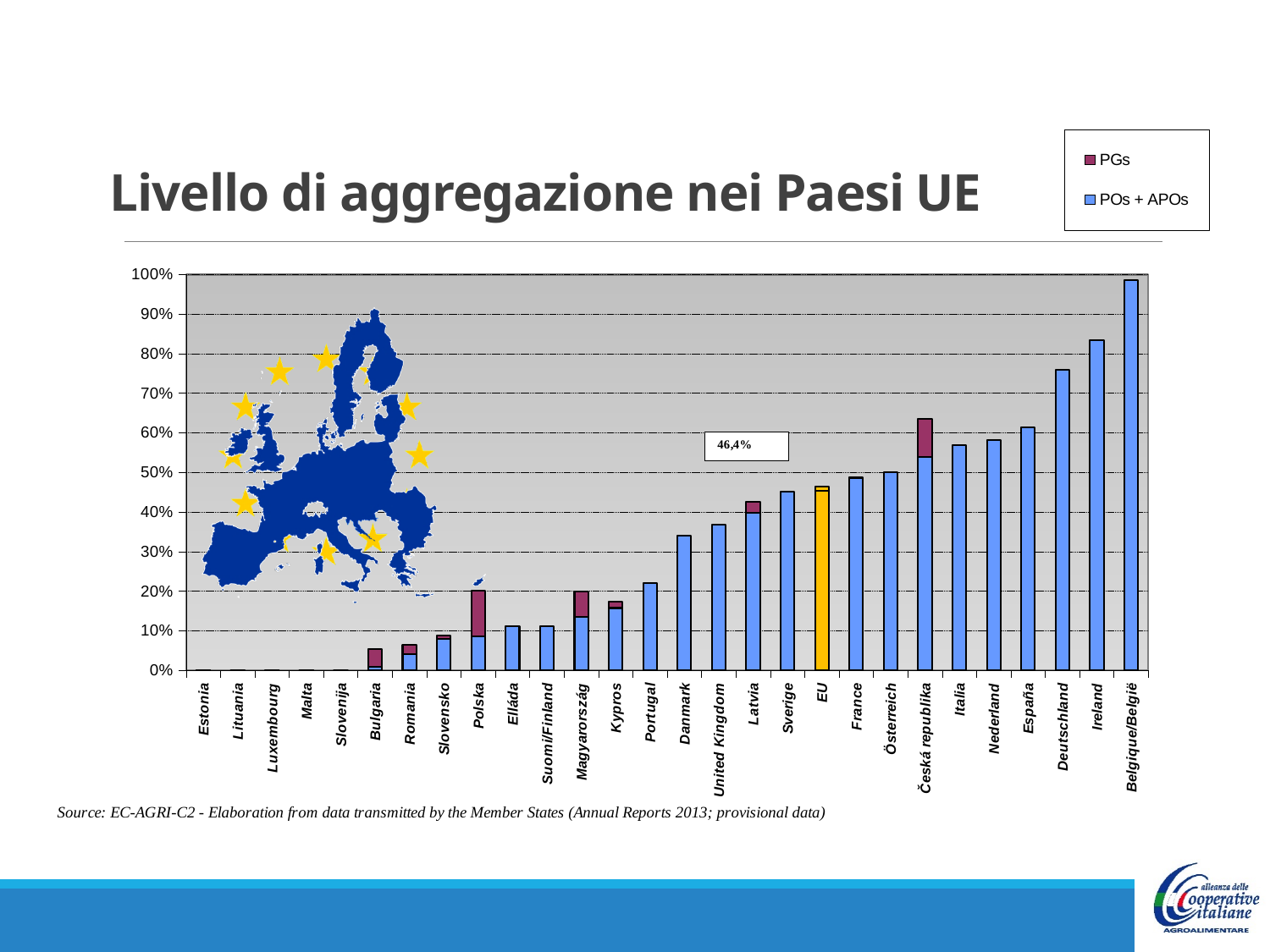
What are the two series named in the legend? PGs and POs + APOs What kind of chart is shown on the slide? Stacked bar chart What value is labelled on the EU bar? 46,4% How many categories are shown on the x axis? 28 What colour is the EU bar, which differs from the other bars? Orange Is the value for Danmark greater or less than 30%? greater Which category has the highest bar? Belgique/België Is the value for Ireland greater or less than 80%? greater Is the value for Deutschland greater or less than 80%? less How many series does the legend list? 2 Do the bar values generally rise or fall from left to right along the x axis? Rise Which is larger, the bar for Ireland or the bar for Deutschland? Ireland